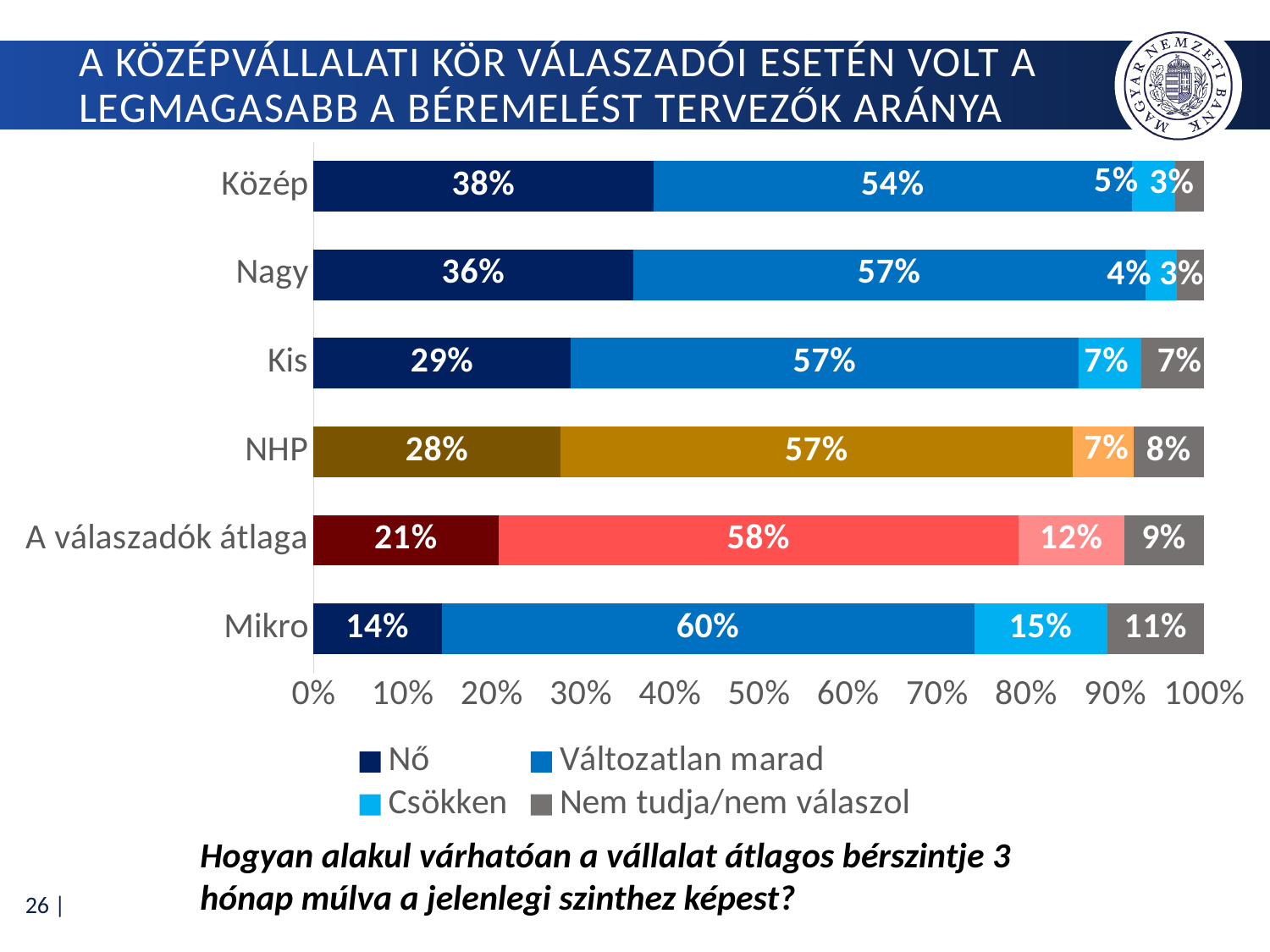
What type of chart is shown on the slide? Stacked bar chart Which category has the lowest "Nő" share? Mikro What is the "Változatlan marad" value for Mikro? 60% What percentage of Közép respondents answered "Nő"? 38% What is the total of the Nagy bar? 100% How many series does the legend list? 4 Which category has the highest "Nő" share? Közép What is the "Csökken" value for A válaszadók átlaga? 12% Which is larger, the "Csökken" value for Mikro or for Kis? Mikro What is the difference between the "Nő" values for Közép and Mikro? 24 percentage points How many categories are shown on the y axis? 6 What is the "Nem tudja/nem válaszol" value for NHP? 8%